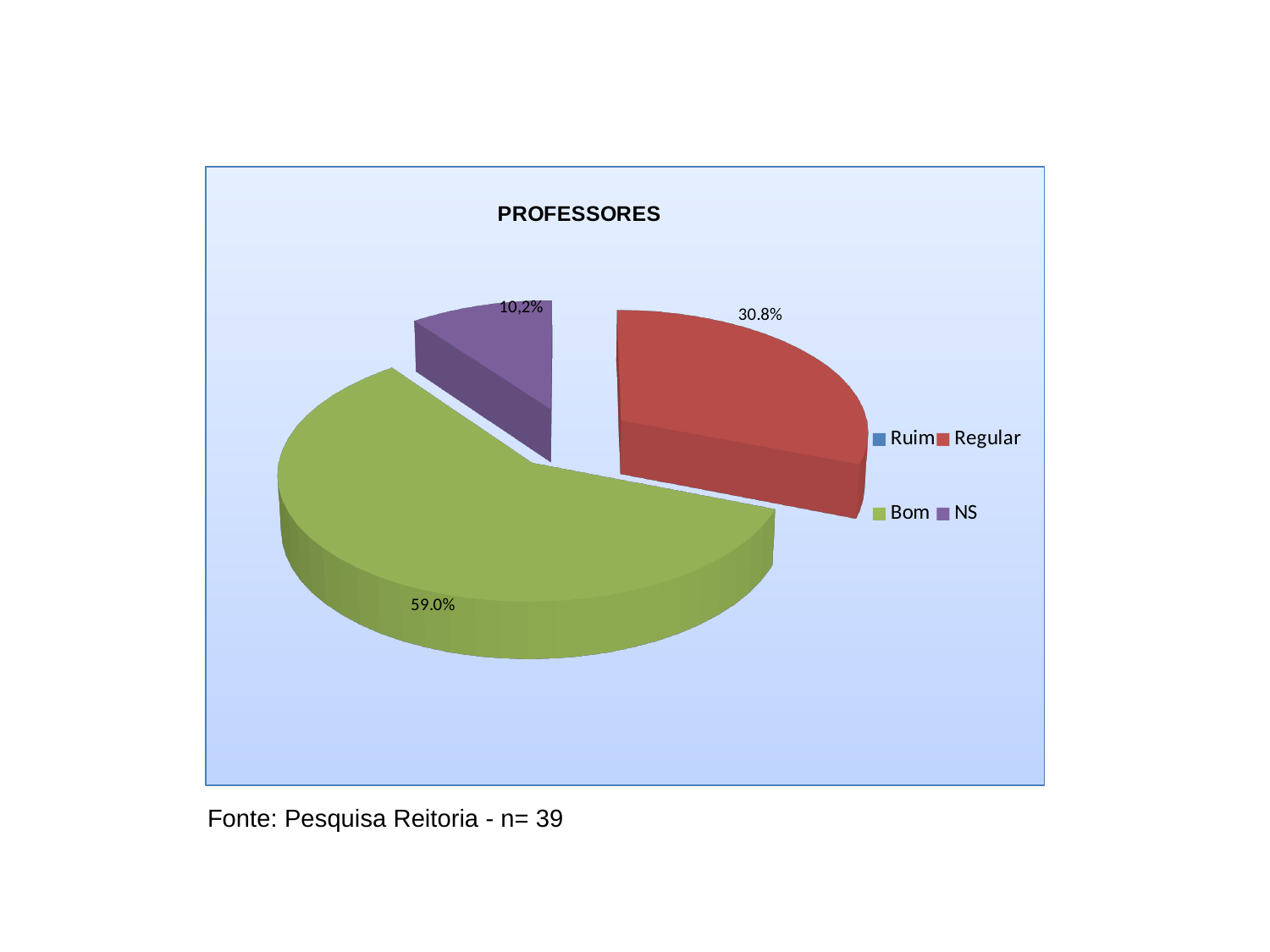
What is the difference between the Regular and NS percentages? 20.6% What kind of chart is shown on the slide? pie chart What colour is the Bom slice? green What percentage is shown for the NS slice? 10,2% What percentage is shown for the Bom slice? 59.0% What is the title of the chart? PROFESSORES Which slice is larger, Regular or NS? Regular What is the difference between the Bom and Regular percentages? 28.2% What share of the pie does the Bom slice represent? 59.0% What percentage is shown for the Regular slice? 30.8% Which category has the largest slice of the pie? Bom How many entries does the legend list? 4